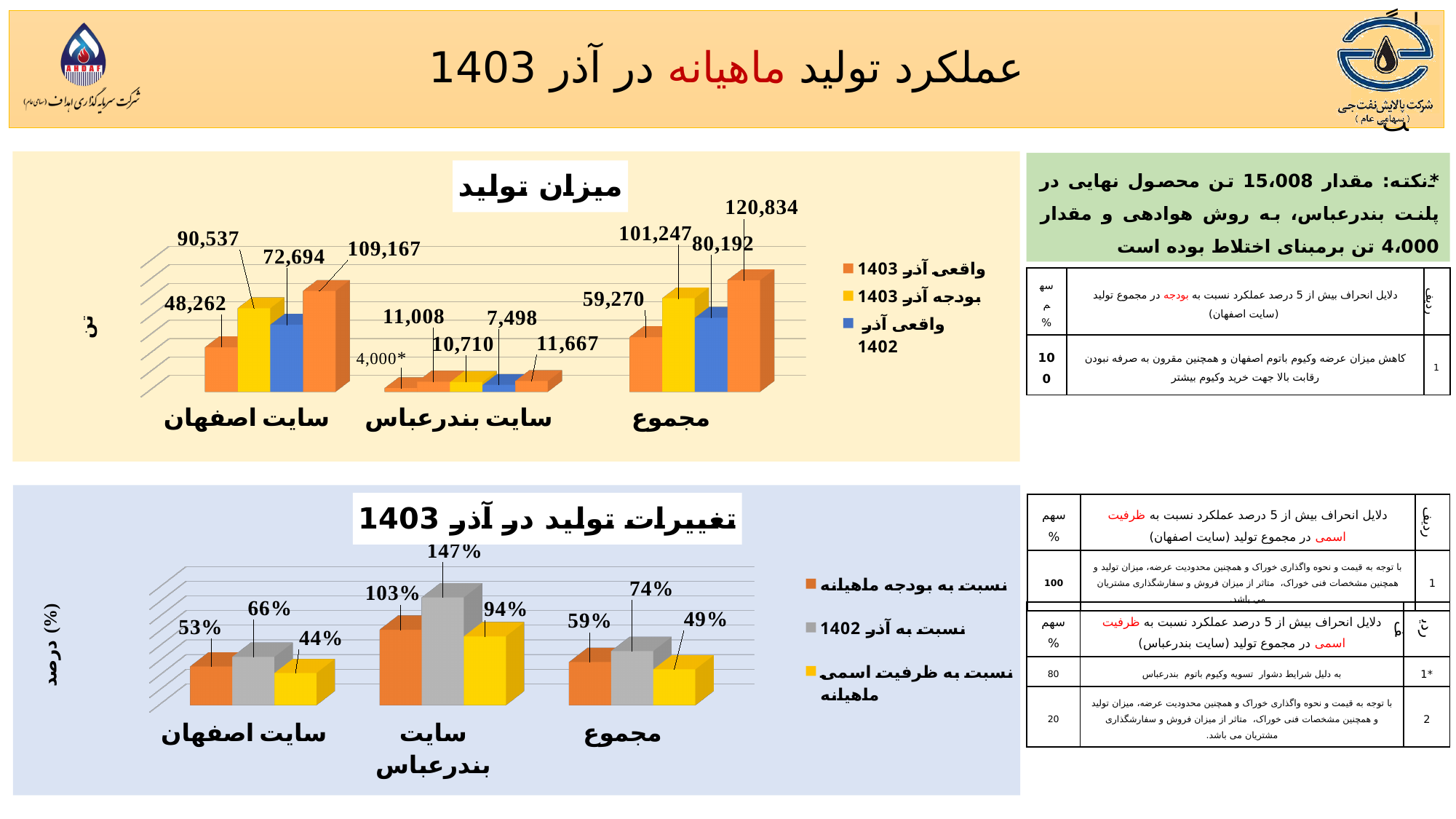
In the bottom chart (تغییرات تولید در آذر 1403), what is the value of نسبت به ظرفیت اسمی ماهیانه for مجموع? 49% What type of chart is the bottom chart (تغییرات تولید در آذر 1403)? bar chart In the top chart (میزان تولید), what is the value of واقعی آذر 1402 for سایت بندرعباس? 7,498 In the top chart (میزان تولید), what is the value of واقعی آذر 1403 for سایت اصفهان? 48,262 In the top chart (میزان تولید), which category has the lowest value for واقعی آذر 1403? سایت بندرعباس In the top chart (میزان تولید), what is the difference between بودجه آذر 1403 and واقعی آذر 1403 for سایت اصفهان? 42,275 In the bottom chart (تغییرات تولید در آذر 1403), which category has the highest value for نسبت به بودجه ماهیانه? سایت بندرعباس In the top chart (میزان تولید), what is the value of بودجه آذر 1403 for مجموع? 101,247 In the bottom chart (تغییرات تولید در آذر 1403), what is the difference between نسبت به آذر 1402 and نسبت به ظرفیت اسمی ماهیانه for سایت اصفهان? 22% In the top chart (میزان تولید), how many categories are shown on the x axis? 3 In the bottom chart (تغییرات تولید در آذر 1403), what is the value of نسبت به آذر 1402 for سایت بندرعباس? 147% In the top chart (میزان تولید), which is larger for مجموع: بودجه آذر 1403 or واقعی آذر 1402? بودجه آذر 1403